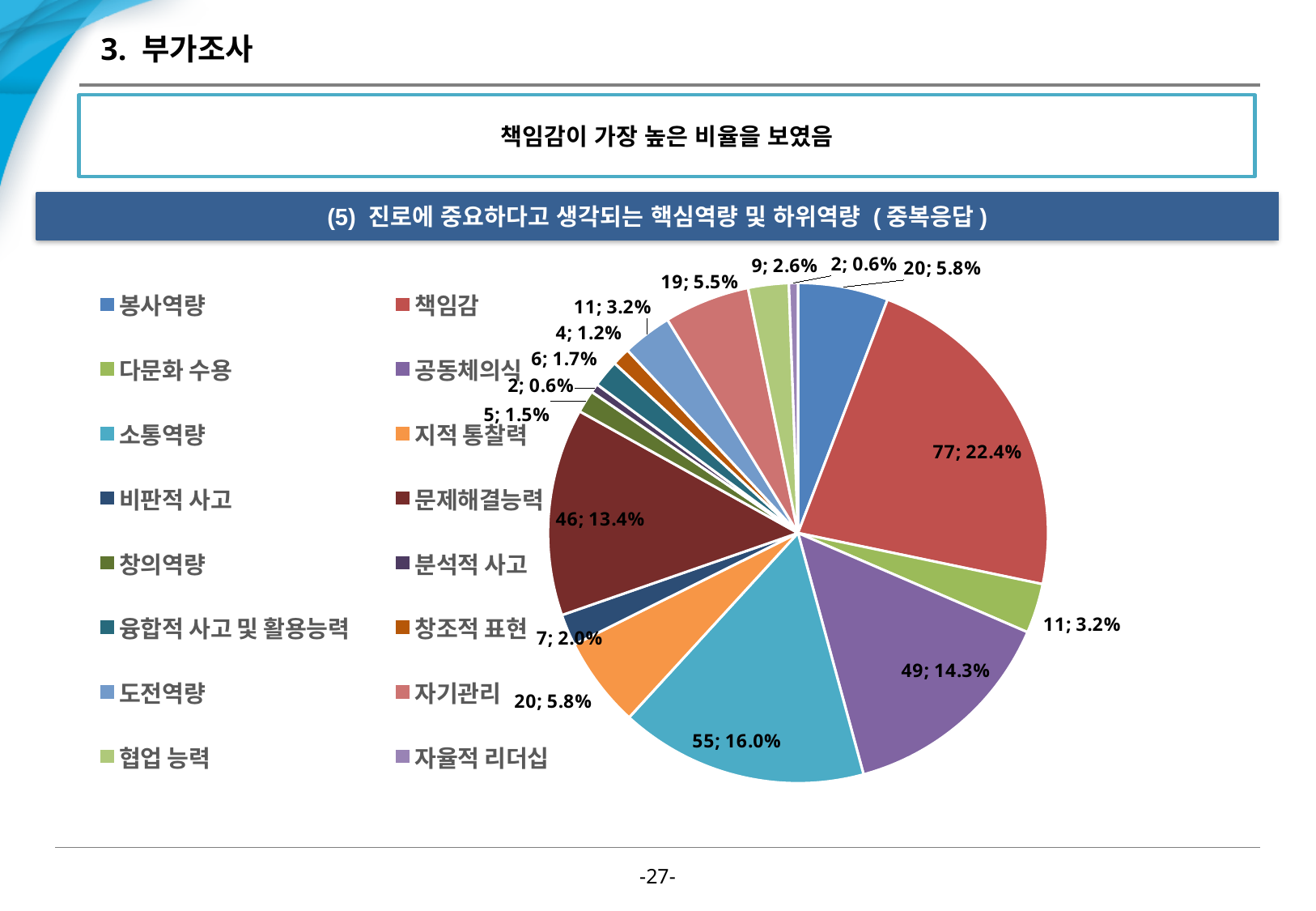
What percentage share does the 소통역량 slice have? 16.0% What percentage share does the 책임감 slice have in the pie chart? 22.4% What count is shown for the 책임감 slice? 77 How many categories does the legend of the pie chart list? 16 Which category has the largest slice in the pie chart? 책임감 What count is shown for the 자기관리 slice? 19 What is the difference in count between the 책임감 slice (77) and the 소통역량 slice (55)? 22 Which is larger, the 소통역량 slice or the 공동체의식 slice? 소통역량 What kind of chart is shown on the slide? pie chart What percentage share does the 문제해결능력 slice have? 13.4% What count is shown for the 공동체의식 slice? 49 What is the title of the chart section on the slide? (5) 진로에 중요하다고 생각되는 핵심역량 및 하위역량 (중복응답)